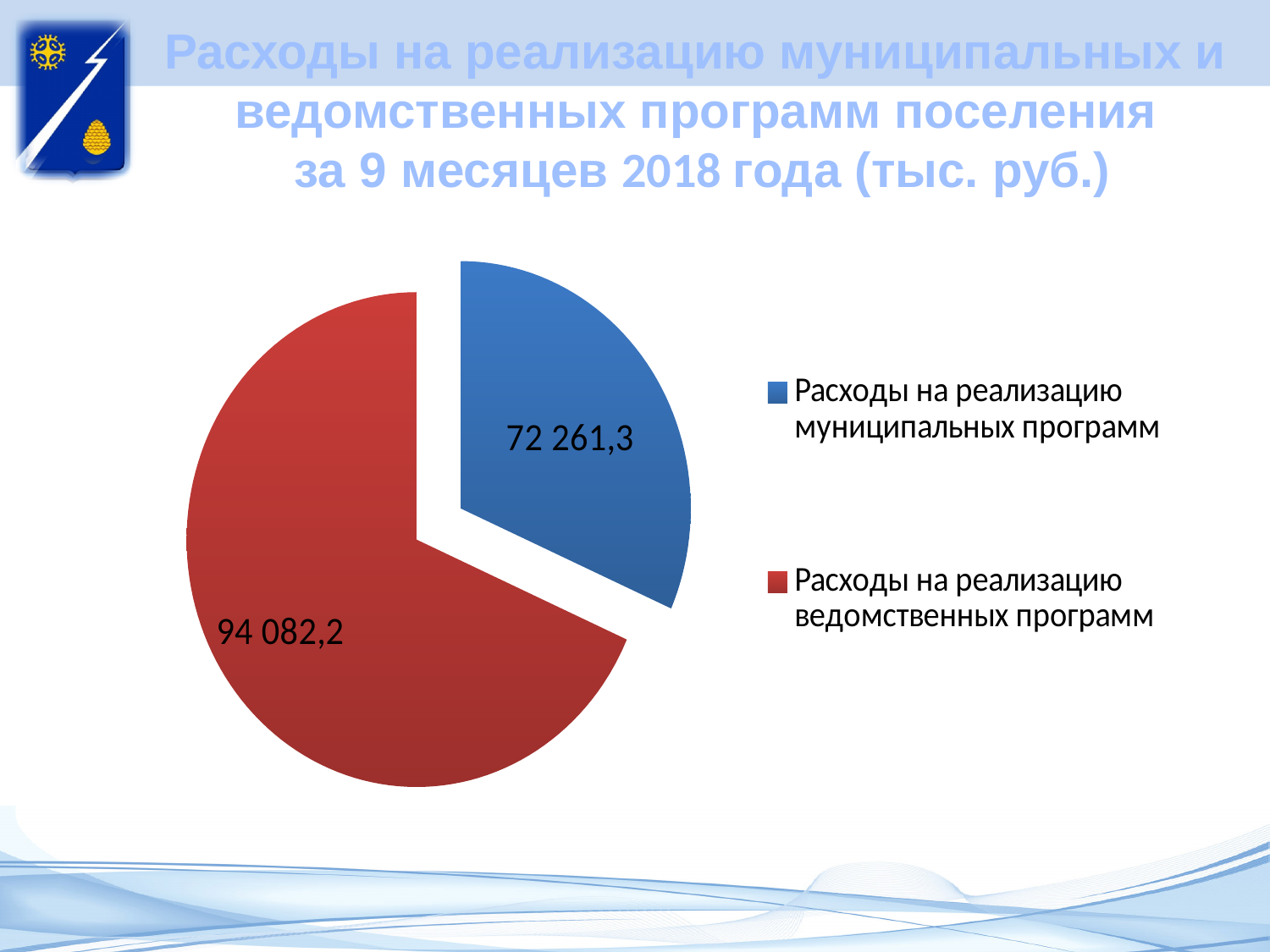
Which is larger: expenses on municipal programs or expenses on departmental programs? Расходы на реализацию ведомственных программ What is the difference between the value for departmental programs and the value for municipal programs? 21 820,9 What colour is the slice for «Расходы на реализацию ведомственных программ»? Red Which category has the largest slice of the pie? Расходы на реализацию ведомственных программ Which category has the smallest slice of the pie? Расходы на реализацию муниципальных программ In what units are the values in the chart expressed, according to the slide title? тыс. руб. What type of chart is shown on the slide? Pie chart What is the value for «Расходы на реализацию ведомственных программ»? 94 082,2 What is the total of the two values shown in the pie chart? 166 343,5 How many slices does the pie chart have? 2 What is the value for «Расходы на реализацию муниципальных программ»? 72 261,3